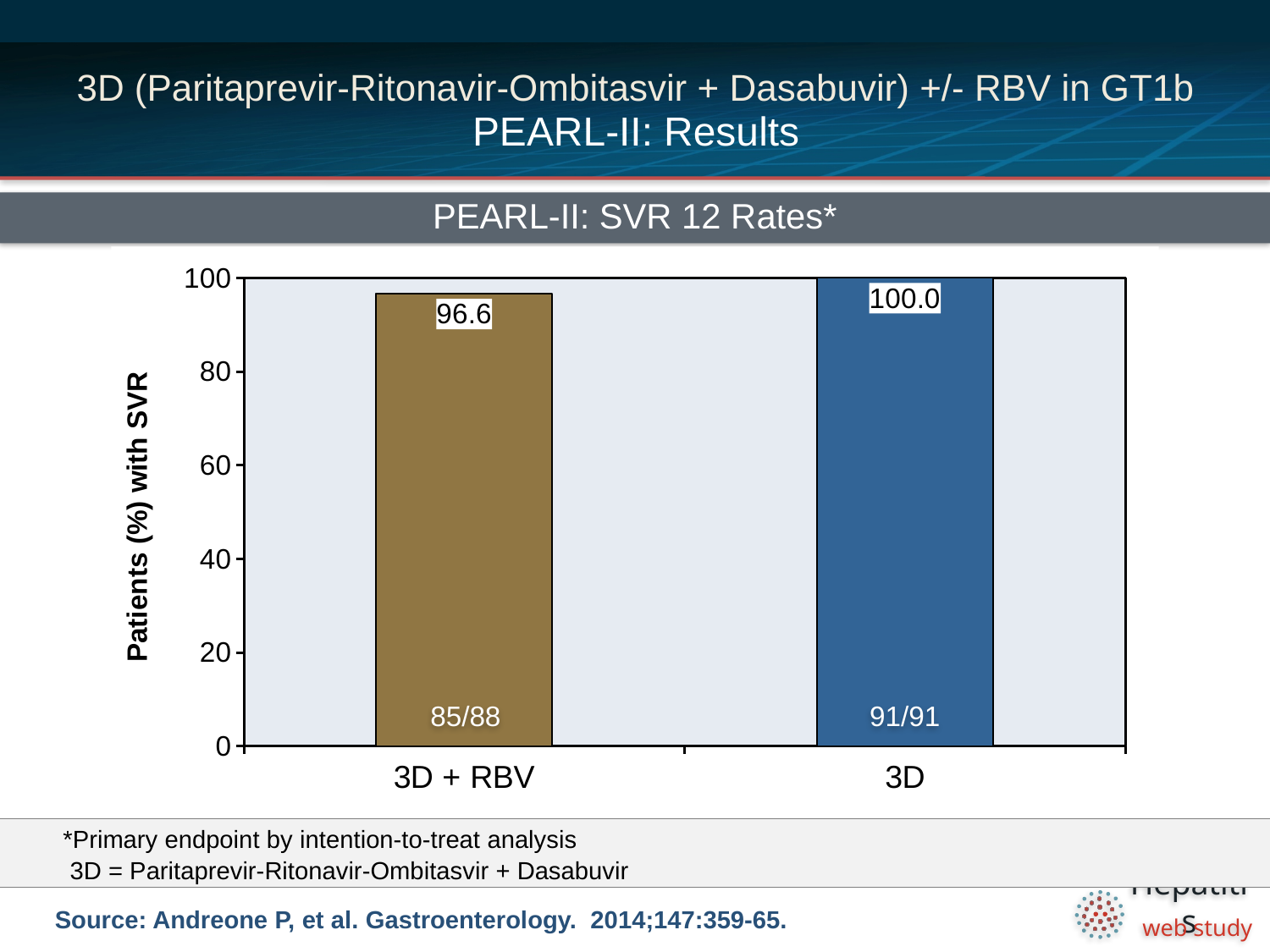
Which group has the lower SVR 12 rate? 3D + RBV What is the difference in SVR 12 rate between the 3D group and the 3D + RBV group? 3.4 What is the title of the chart? PEARL-II: SVR 12 Rates* What fraction of patients achieved SVR in the 3D + RBV group? 85/88 What is the SVR 12 rate for the 3D + RBV group? 96.6 What is the SVR 12 rate for the 3D group? 100.0 Which group has the higher SVR 12 rate? 3D What fraction of patients achieved SVR in the 3D group? 91/91 Is the SVR 12 rate for 3D + RBV greater or less than 80? greater What kind of chart is shown on the slide? Bar chart How many treatment groups are shown in the chart? 2 What is the label of the y-axis? Patients (%) with SVR